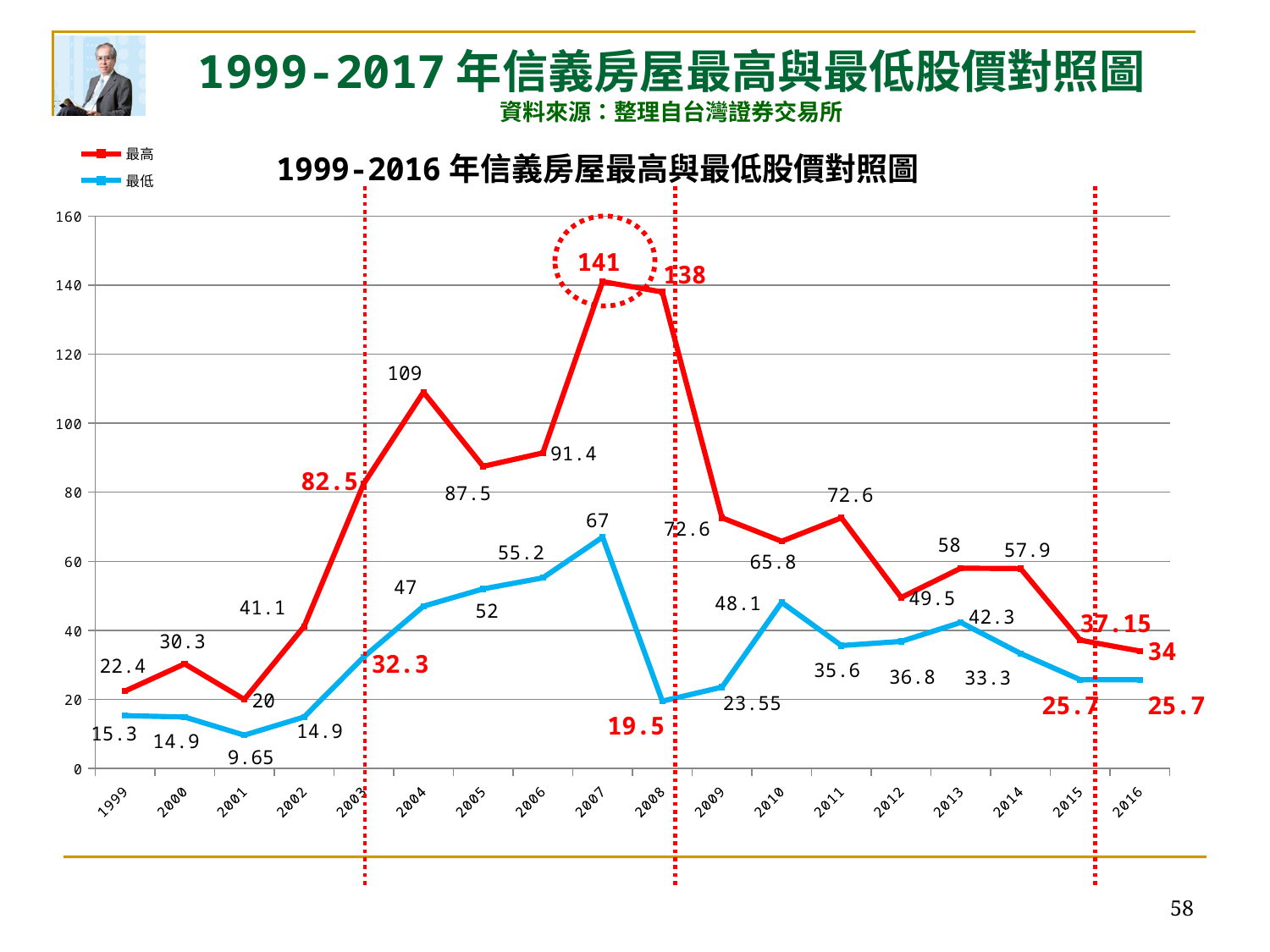
What kind of chart is shown? Line chart What is the 最高 value for 2004? 109 What is the 最低 value for 2001? 9.65 Which is larger, the 最高 value for 2009 or the 最高 value for 2011? They are equal (72.6) What is the 最高 value for 2007? 141 What is the difference between the 最高 and 最低 values in 2007? 74 In which year is the 最低 series at its lowest? 2001 How many series does the legend list? 2 What is the 最低 value for 2008? 19.5 How many years are plotted on the x axis? 18 Which is larger, the 最低 value for 2010 or the 最低 value for 2013? 2010 In which year is the 最高 series at its highest? 2007